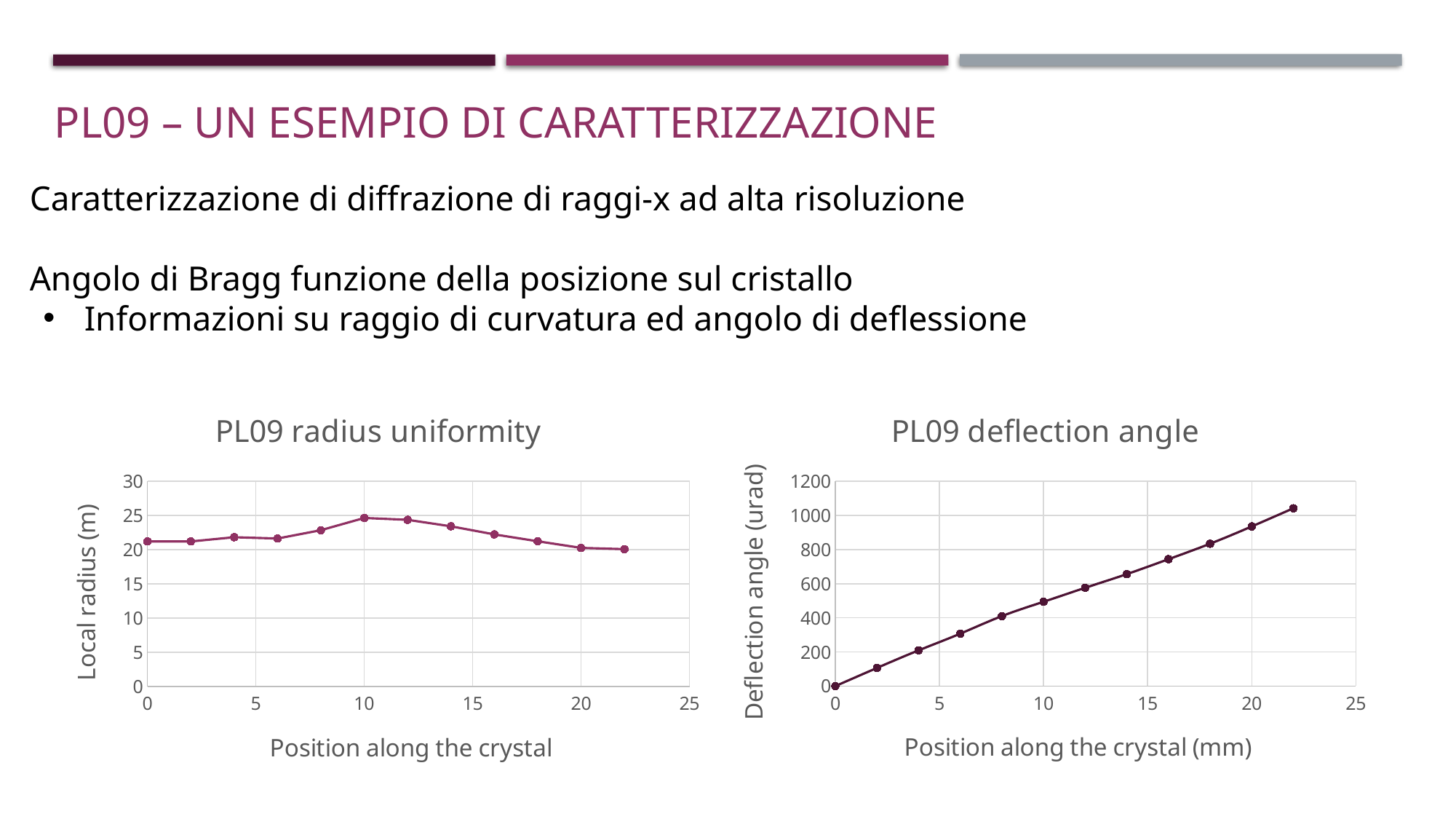
In the 'PL09 deflection angle' chart, is the deflection angle at position 10 mm greater or less than 600? less In the 'PL09 radius uniformity' chart, is the local radius at position 0 greater or less than 20? greater In the 'PL09 deflection angle' chart, is the deflection angle at position 22 mm greater or less than 1000? greater How many data points are plotted in the 'PL09 deflection angle' chart? 12 What type of chart is the 'PL09 radius uniformity' chart? line chart In the 'PL09 radius uniformity' chart, at which position along the crystal is the local radius highest? 10 What type of chart is the 'PL09 deflection angle' chart? line chart In the 'PL09 deflection angle' chart, at which position along the crystal is the deflection angle highest? 22 In the 'PL09 deflection angle' chart, do the values rise or fall as the position along the crystal increases? rise What is the y-axis label of the 'PL09 deflection angle' chart? Deflection angle (urad) In the 'PL09 radius uniformity' chart, which is larger: the local radius at position 10 or at position 20? position 10